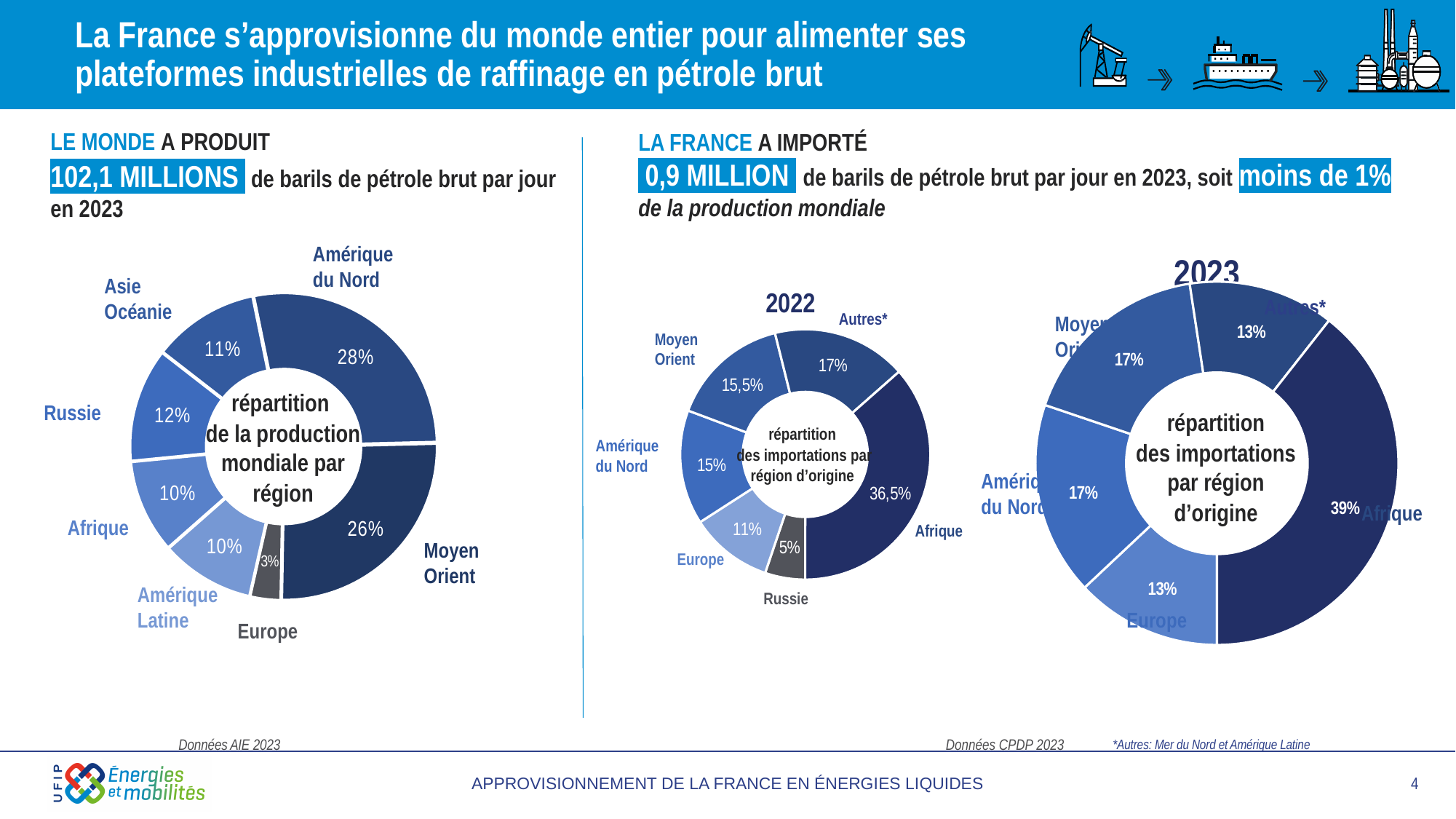
In the 2023 chart (répartition des importations par région d'origine), what share comes from Afrique? 39% In the 2022 chart (répartition des importations par région d'origine), what share comes from Moyen Orient? 15,5% In the 2022 chart (répartition des importations par région d'origine), which region has the smallest share? Russie In the left chart (répartition de la production mondiale par région), what share does Amérique du Nord hold? 28% In the 2022 chart (répartition des importations par région d'origine), what share comes from Afrique? 36,5% In the left chart (répartition de la production mondiale par région), what is the difference between the shares of Moyen Orient and Russie? 14% In the left chart (répartition de la production mondiale par région), which region has the smallest share? Europe What kind of chart is used for the répartition de la production mondiale par région? Donut (pie) chart In the left chart (répartition de la production mondiale par région), how many regions are shown? 7 In the 2023 chart (répartition des importations par région d'origine), how many regions are shown? 5 In the 2023 chart (répartition des importations par région d'origine), which is larger: the share of Europe or the share of Amérique du Nord? Amérique du Nord In the left chart (répartition de la production mondiale par région), which region has the largest share? Amérique du Nord